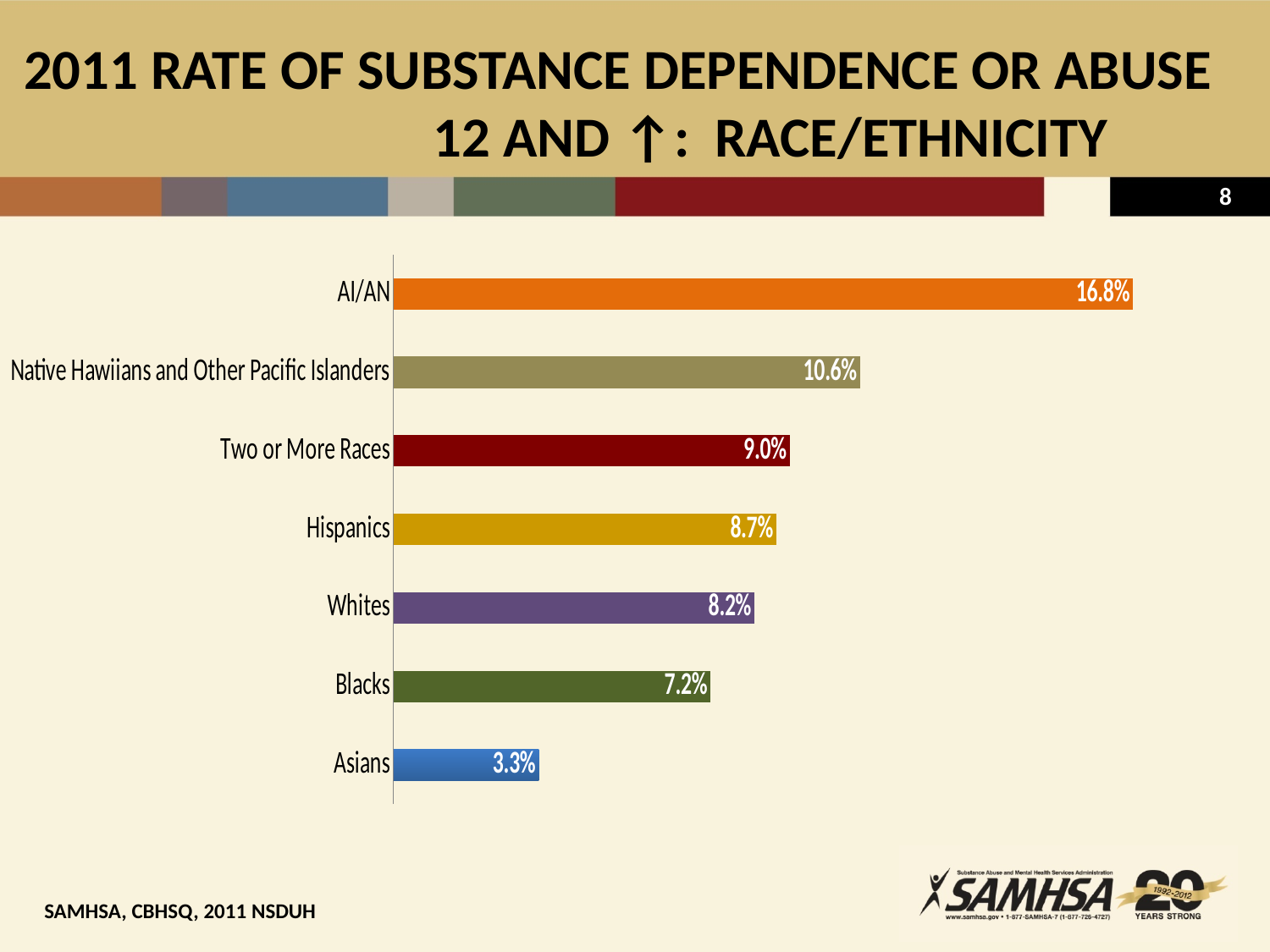
Which race/ethnicity group has the highest rate? AI/AN Which group has a higher rate, Whites or Blacks? Whites What is the difference between the rates for Two or More Races and Whites? 0.8% What type of chart is shown on the slide? Bar chart What is the rate shown for Native Hawiians and Other Pacific Islanders? 10.6% What is the rate shown for Hispanics? 8.7% Which race/ethnicity group has the lowest rate? Asians What is the difference between the rates for AI/AN and Asians? 13.5% What is the rate shown for Blacks? 7.2% What is the rate of substance dependence or abuse for AI/AN? 16.8% How many race/ethnicity groups are shown in the chart? 7 What colour is the bar for Asians? Blue